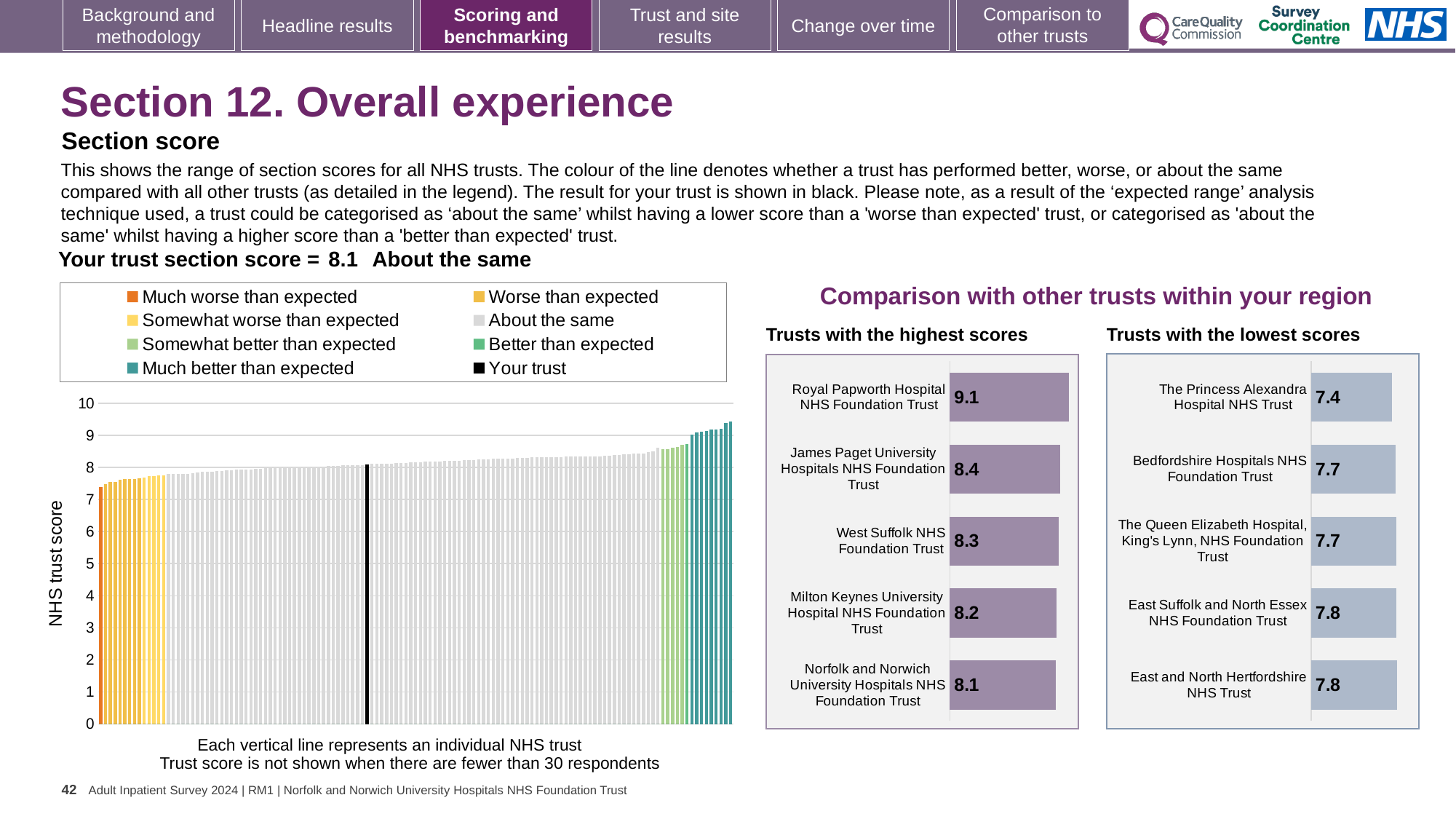
In the 'Trusts with the lowest scores' chart, what is the difference between the scores of East Suffolk and North Essex NHS Foundation Trust and The Princess Alexandra Hospital NHS Trust? 0.4 In the 'Trusts with the lowest scores' chart, which trust has the lowest score? The Princess Alexandra Hospital NHS Trust How many trusts are shown in the 'Trusts with the lowest scores' chart? 5 In the 'Trusts with the highest scores' chart, what is the difference between the scores of Royal Papworth Hospital NHS Foundation Trust and Norfolk and Norwich University Hospitals NHS Foundation Trust? 1.0 How many entries does the legend of the main 'NHS trust score' chart on the left list? 8 In the 'Trusts with the highest scores' chart, what is the score for Royal Papworth Hospital NHS Foundation Trust? 9.1 How many trusts are shown in the 'Trusts with the highest scores' chart? 5 In the 'Trusts with the highest scores' chart, which has the larger score: James Paget University Hospitals NHS Foundation Trust or West Suffolk NHS Foundation Trust? James Paget University Hospitals NHS Foundation Trust In the 'Trusts with the lowest scores' chart, what is the score for The Princess Alexandra Hospital NHS Trust? 7.4 In the 'Trusts with the highest scores' chart, which trust has the highest score? Royal Papworth Hospital NHS Foundation Trust In the main 'NHS trust score' chart on the left, do the trust scores rise or fall from left to right? rise What kind of chart is the 'Trusts with the lowest scores' chart? bar chart